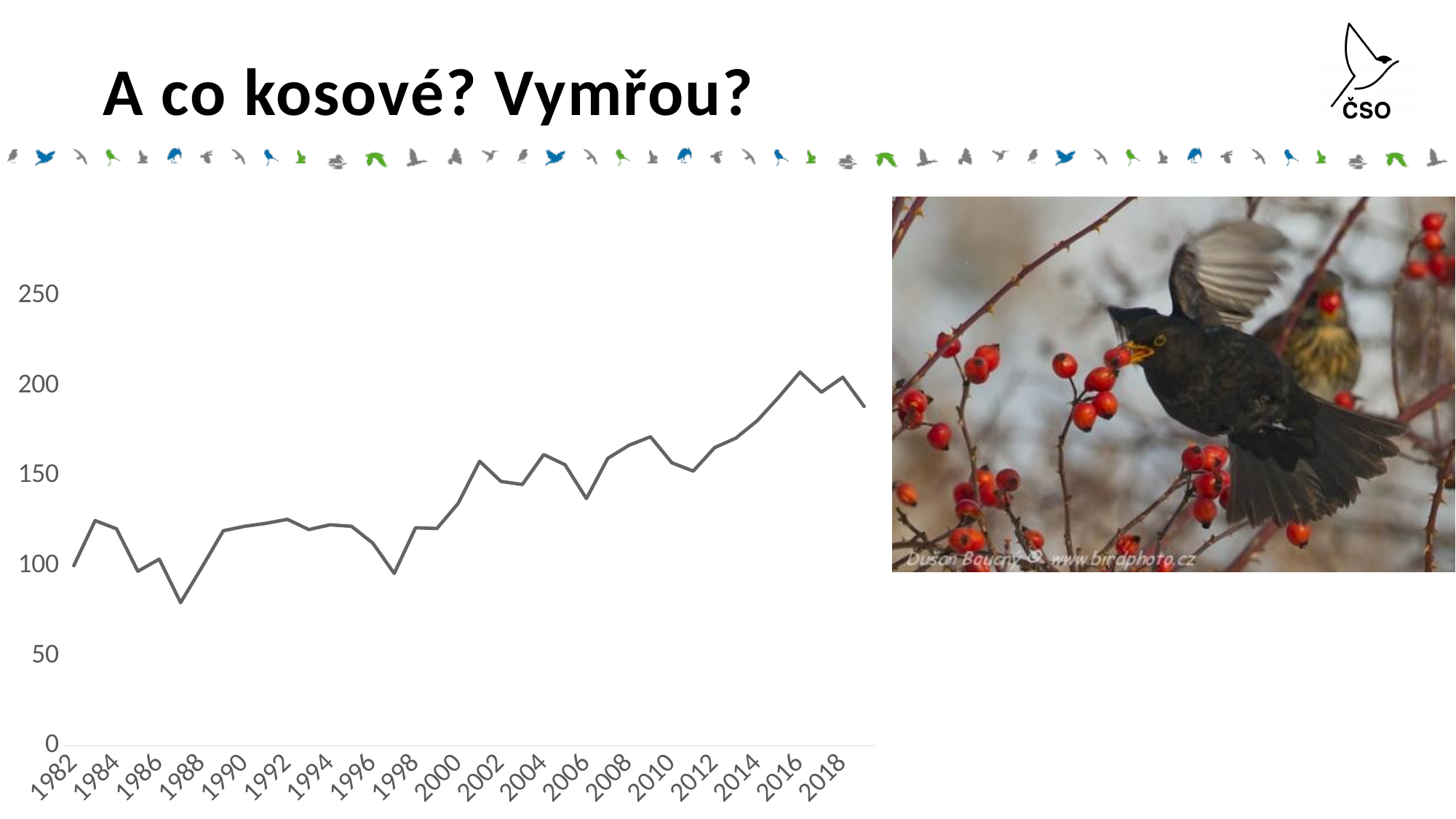
Which year has the larger value, 1990 or 2010? 2010 Overall, do the values rise or fall from 1982 to the end of the series? rise What is the highest value labelled on the vertical axis? 250 Is the value for 2010 greater or less than 150? greater Is the value for 2016 greater or less than 200? greater Is the value for 2019 greater or less than 150? greater Which year has the larger value, 1983 or 1987? 1983 What kind of chart is shown on the slide? line chart In which year does the line reach its highest value? 2016 In which year does the line reach its lowest value? 1987